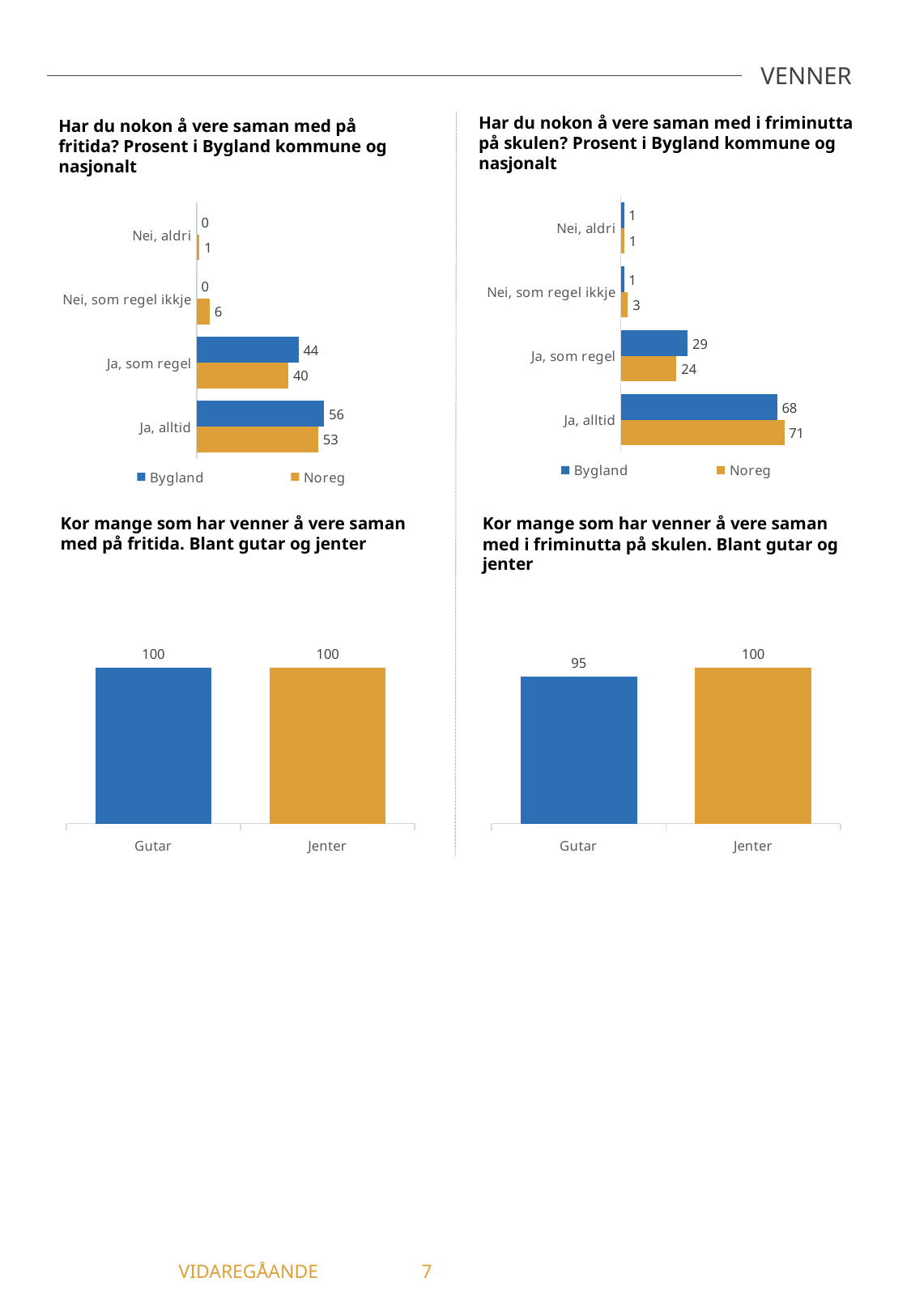
In the top-right chart (Har du nokon å vere saman med i friminutta på skulen?), how many categories are shown? 4 In the top-right chart (Har du nokon å vere saman med i friminutta på skulen?), which category has the highest value for Bygland? Ja, alltid In the top-right chart (Har du nokon å vere saman med i friminutta på skulen?), what is the value for Noreg in the category 'Ja, alltid'? 71 In the bottom-right chart (Kor mange som har venner å vere saman med i friminutta på skulen), what is the value for Gutar? 95 In the top-left chart (Har du nokon å vere saman med på fritida?), how many series does the legend list? 2 In the bottom-right chart (Kor mange som har venner å vere saman med i friminutta på skulen), what is the difference between Jenter and Gutar? 5 In the top-right chart (Har du nokon å vere saman med i friminutta på skulen?), which is larger for 'Ja, som regel': Bygland or Noreg? Bygland In the top-left chart (Har du nokon å vere saman med på fritida?), what is the value for Noreg in the category 'Nei, som regel ikkje'? 6 In the top-left chart (Har du nokon å vere saman med på fritida?), what is the difference between Bygland and Noreg for 'Ja, som regel'? 4 In the top-left chart (Har du nokon å vere saman med på fritida?), what is the value for Bygland in the category 'Ja, alltid'? 56 In the bottom-left chart (Kor mange som har venner å vere saman med på fritida), what is the value for Jenter? 100 What kind of chart is the bottom-left chart (Kor mange som har venner å vere saman med på fritida)? Bar chart